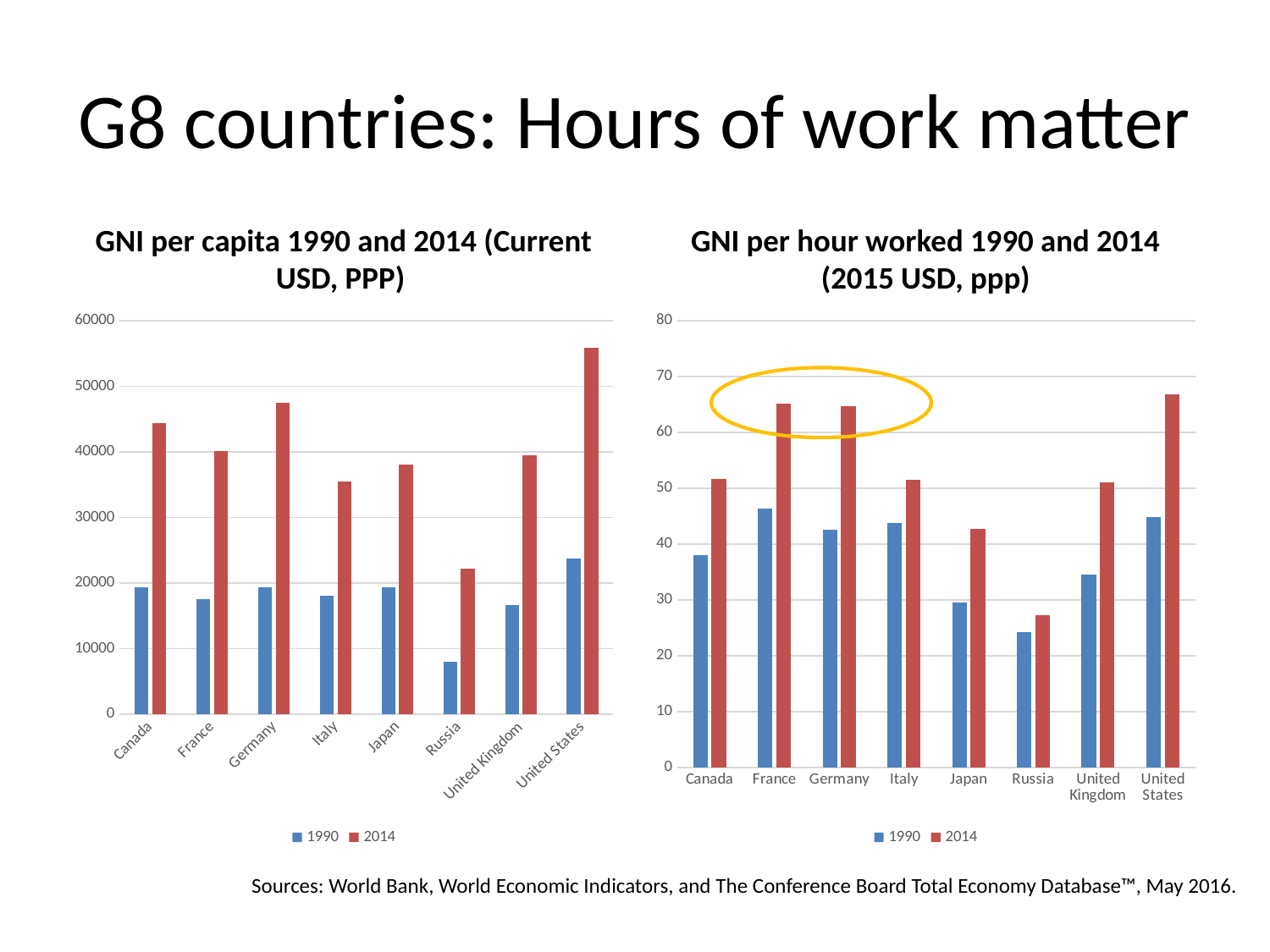
On the 'GNI per capita 1990 and 2014' chart, which country has the lowest 1990 value? Russia On the 'GNI per hour worked 1990 and 2014' chart, which countries' 2014 bars are circled in yellow? France and Germany On the 'GNI per capita 1990 and 2014' chart, which is larger in 2014: Germany or France? Germany On the 'GNI per hour worked 1990 and 2014' chart, which country has the highest 2014 value? United States On the 'GNI per capita 1990 and 2014' chart, is the 2014 value for the United States greater or less than 50000? greater On the 'GNI per hour worked 1990 and 2014' chart, is the 2014 value for France greater or less than 60? greater What kind of chart is the 'GNI per capita 1990 and 2014 (Current USD, PPP)' chart? bar chart On the 'GNI per capita 1990 and 2014' chart, which country has the highest 2014 value? United States On the 'GNI per capita 1990 and 2014' chart, is the 1990 value for Russia greater or less than 10000? less How many series does the legend of the 'GNI per capita 1990 and 2014' chart list? 2 On the 'GNI per hour worked 1990 and 2014' chart, which country has the lowest 2014 value? Russia How many countries are shown on the 'GNI per hour worked 1990 and 2014 (2015 USD, ppp)' chart? 8